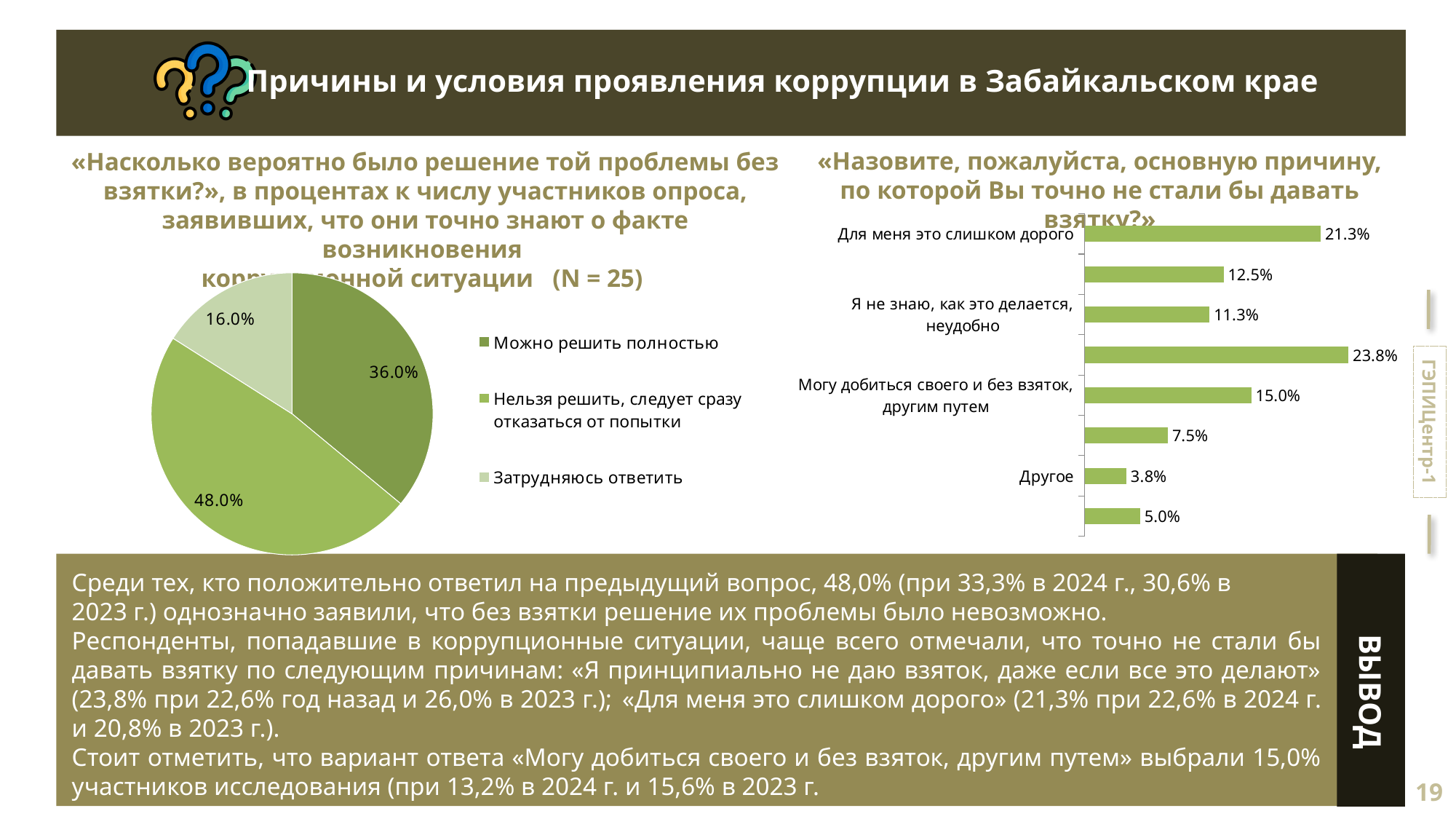
In the right bar chart, which is larger: the value for «Для меня это слишком дорого» or for «Я не знаю, как это делается, неудобно»? Для меня это слишком дорого In the right bar chart, what is the value for «Для меня это слишком дорого»? 21.3% What kind of chart is the right chart on the slide? bar chart In the left pie chart, which category has the largest slice? Нельзя решить, следует сразу отказаться от попытки In the left pie chart, what is the difference between the shares for «Нельзя решить, следует сразу отказаться от попытки» and «Можно решить полностью»? 12.0% How many bars are plotted in the right bar chart? 8 In the right bar chart, what is the value for «Могу добиться своего и без взяток, другим путем»? 15.0% In the right bar chart, which labelled category has the lowest value? Другое In the left pie chart, what share is shown for «Затрудняюсь ответить»? 16.0% In the left pie chart, what share is shown for «Нельзя решить, следует сразу отказаться от попытки»? 48.0% How many entries does the legend of the left pie chart list? 3 What kind of chart is the left chart on the slide? pie chart